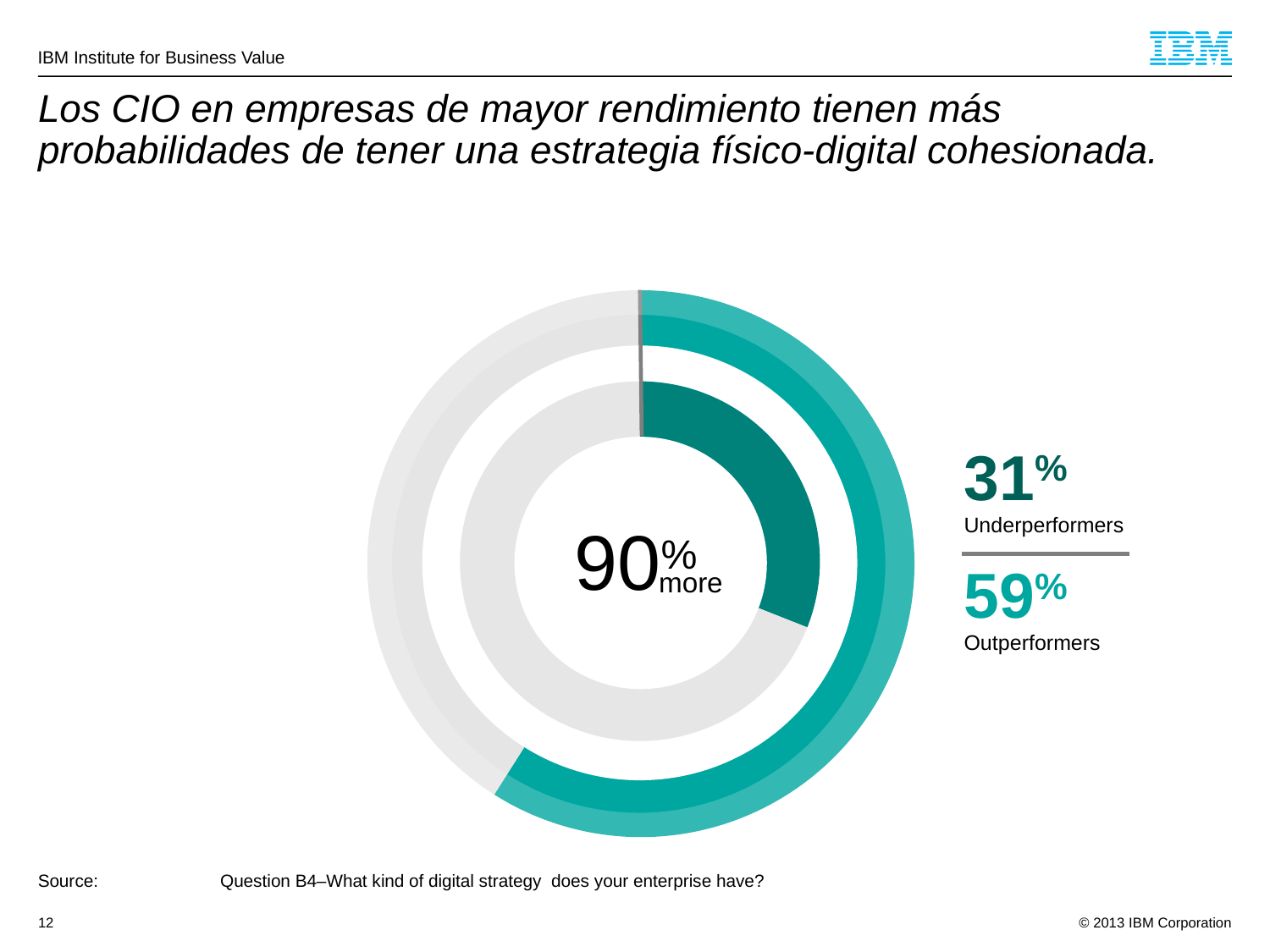
Is the value for Outperformers greater or less than 50%? greater Which group has the higher percentage, Underperformers or Outperformers? Outperformers Which ring of the donut chart, inner or outer, represents Outperformers? Outer What kind of chart is shown on the slide? Donut chart Is the value for Underperformers greater or less than 50%? less How many groups are plotted on the chart? 2 What percentage is shown for Underperformers? 31% What is the difference in percentage points between Outperformers and Underperformers? 28 What percentage is shown for Outperformers? 59% Which group has the lowest percentage shown on the chart? Underperformers What text is printed in the centre of the donut chart? 90% more Which group has the highest percentage shown on the chart? Outperformers